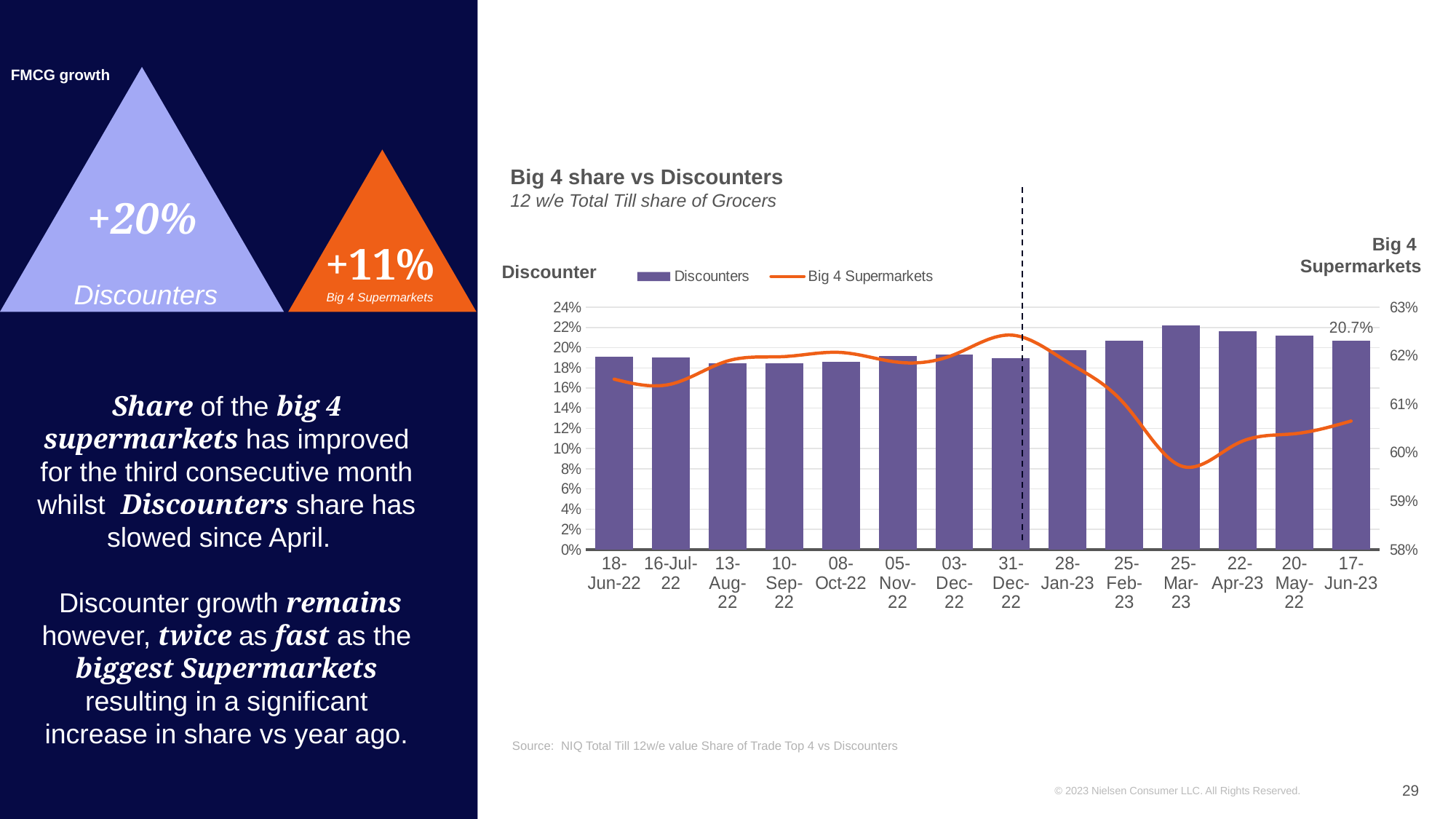
What is the subtitle shown under the chart title 'Big 4 share vs Discounters'? 12 w/e Total Till share of Grocers Is the Big 4 Supermarkets value for 25-Mar-23 greater or less than 60%? less In which period does the Big 4 Supermarkets line reach its lowest point? 25-Mar-23 What kind of chart is used to show Big 4 share vs Discounters? Combined bar and line chart How many series does the chart legend list? 2 In which period is the Discounters bar the highest? 25-Mar-23 How many time periods are shown on the x axis of the chart? 14 Does the Big 4 Supermarkets line rise or fall between 31-Dec-22 and 25-Mar-23? Fall Which is larger, the Discounters bar for 25-Feb-23 or for 31-Dec-22? 25-Feb-23 What is the Discounters share shown for 17-Jun-23? 20.7% Is the Discounters value for 25-Mar-23 greater or less than 20%? greater In which period does the Big 4 Supermarkets line reach its highest point? 31-Dec-22